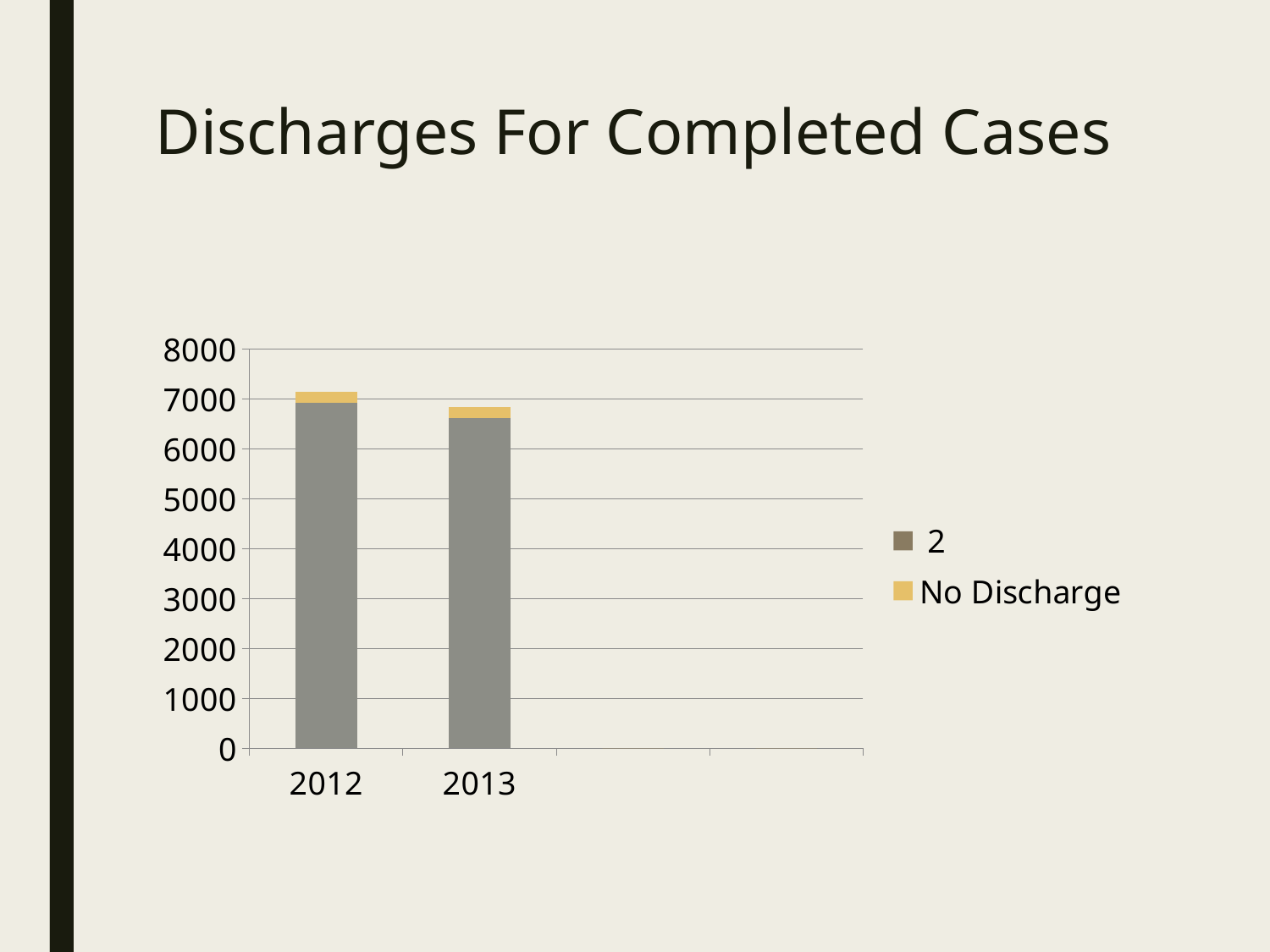
Do the total bar heights rise or fall from 2012 to 2013? Fall Which series makes up the larger part of each stacked bar, "2" or "No Discharge"? 2 Which year has the taller stacked bar, 2012 or 2013? 2012 What are the two series named in the legend? 2 and No Discharge Is the value of the "2" series for 2013 greater or less than 6000? greater What is the title of the chart on the slide? Discharges For Completed Cases Is the total stacked bar for 2013 greater or less than 7000? less What kind of chart is shown on the slide? Stacked bar chart Is the value of the "2" series for 2012 greater or less than 6000? greater How many years are shown on the x axis of the chart? 2 How many series does the legend list? 2